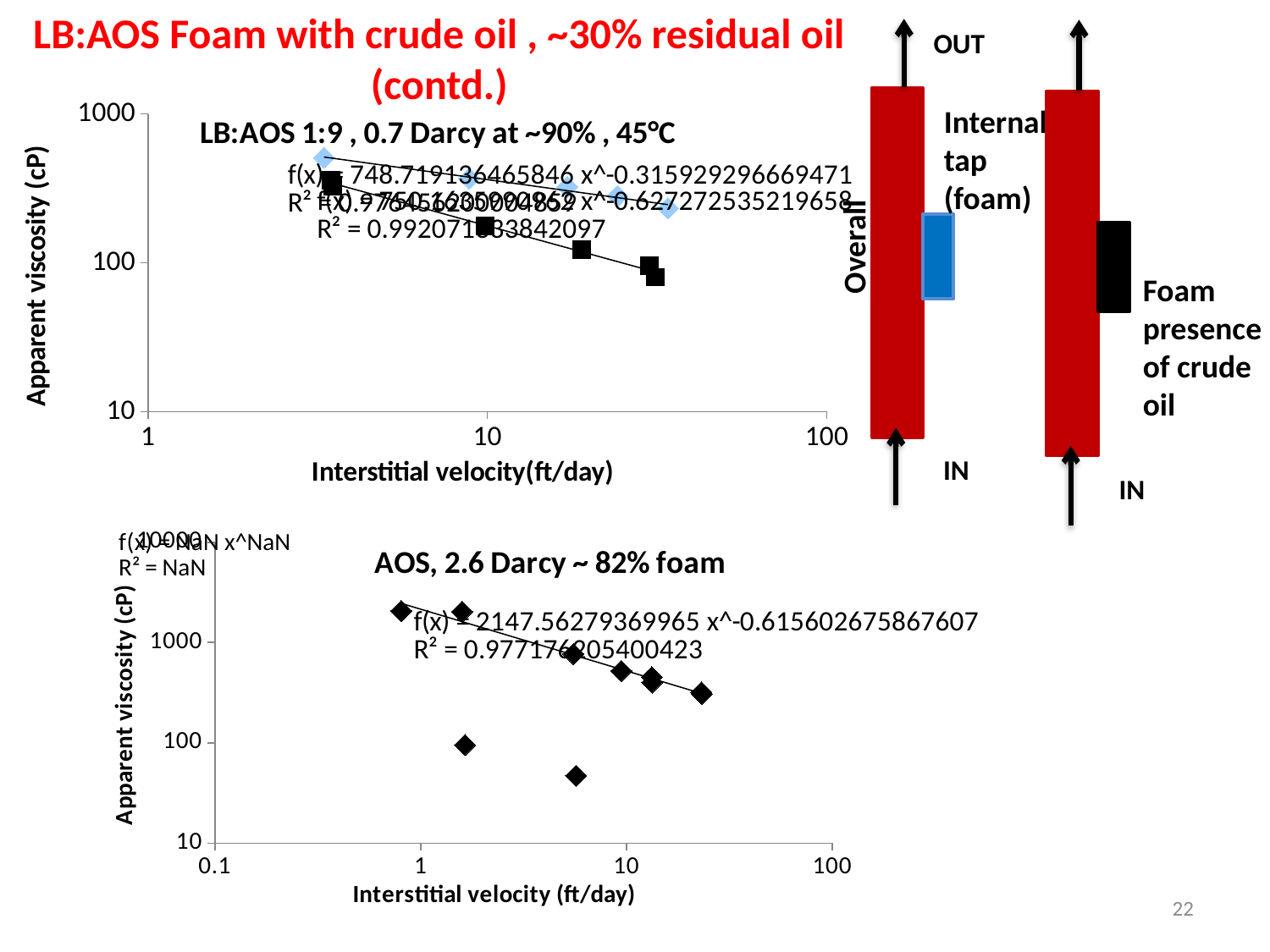
In the bottom chart, is the apparent viscosity of the point at the lowest interstitial velocity greater or less than 1000 cP? greater In the bottom chart, is the apparent viscosity of the point at the highest interstitial velocity greater or less than 1000 cP? less In the top chart, do the apparent viscosity values rise or fall as interstitial velocity increases? Fall What is the label of the y-axis on the bottom chart? Apparent viscosity (cP) In the bottom chart, do the apparent viscosity values along the trendline rise or fall as interstitial velocity increases? Fall What is the smallest tick value shown on the x-axis of the bottom chart? 0.1 In the top chart, is the apparent viscosity of the lowest black square point greater or less than 100 cP? less What kind of chart is the top chart titled "LB:AOS 1:9 , 0.7 Darcy at ~90% , 45°C"? Scatter chart What kind of chart is the bottom chart titled "AOS, 2.6 Darcy ~ 82% foam"? Scatter chart